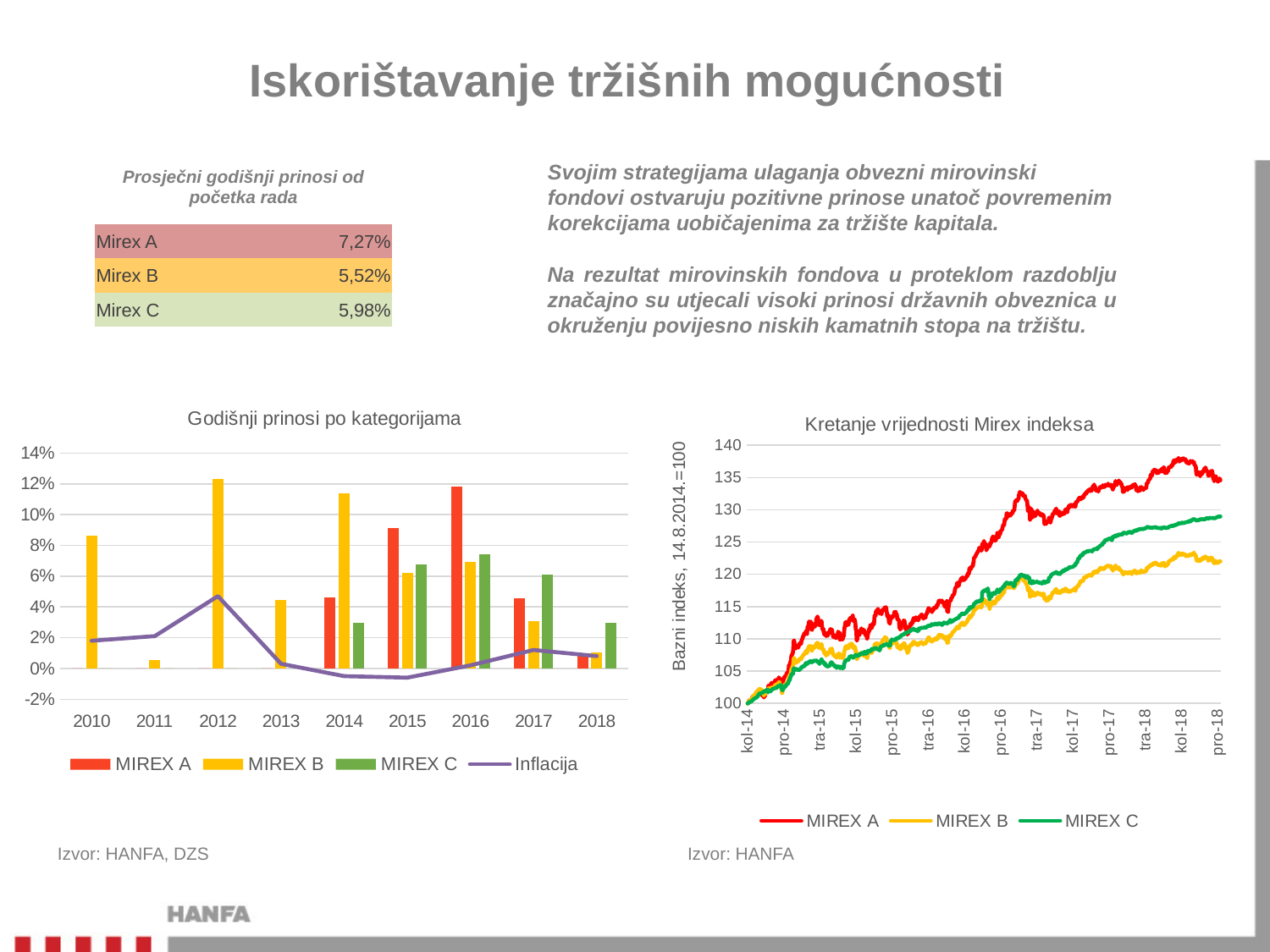
In "Kretanje vrijednosti Mirex indeksa", is the value of MIREX A at pro-18 greater or less than 130? greater How many series does the legend of "Godišnji prinosi po kategorijama" list? 4 In "Kretanje vrijednosti Mirex indeksa", which series has the highest value at the end of the period (pro-18)? MIREX A In "Kretanje vrijednosti Mirex indeksa", do the index values generally rise or fall from kol-14 to pro-18? rise How many years are shown on the x axis of "Godišnji prinosi po kategorijama"? 9 In "Godišnji prinosi po kategorijama", is the MIREX B value for 2012 greater or less than 10%? greater What is the y-axis label of "Kretanje vrijednosti Mirex indeksa"? Bazni indeks, 14.8.2014.=100 What kind of chart is "Kretanje vrijednosti Mirex indeksa"? line chart In "Kretanje vrijednosti Mirex indeksa", is the value of MIREX B at pro-18 greater or less than 125? less In "Godišnji prinosi po kategorijama", which is larger in 2015, MIREX A or MIREX B? MIREX A How many series does the legend of "Kretanje vrijednosti Mirex indeksa" list? 3 In "Kretanje vrijednosti Mirex indeksa", which series has the lowest value at the end of the period (pro-18)? MIREX B